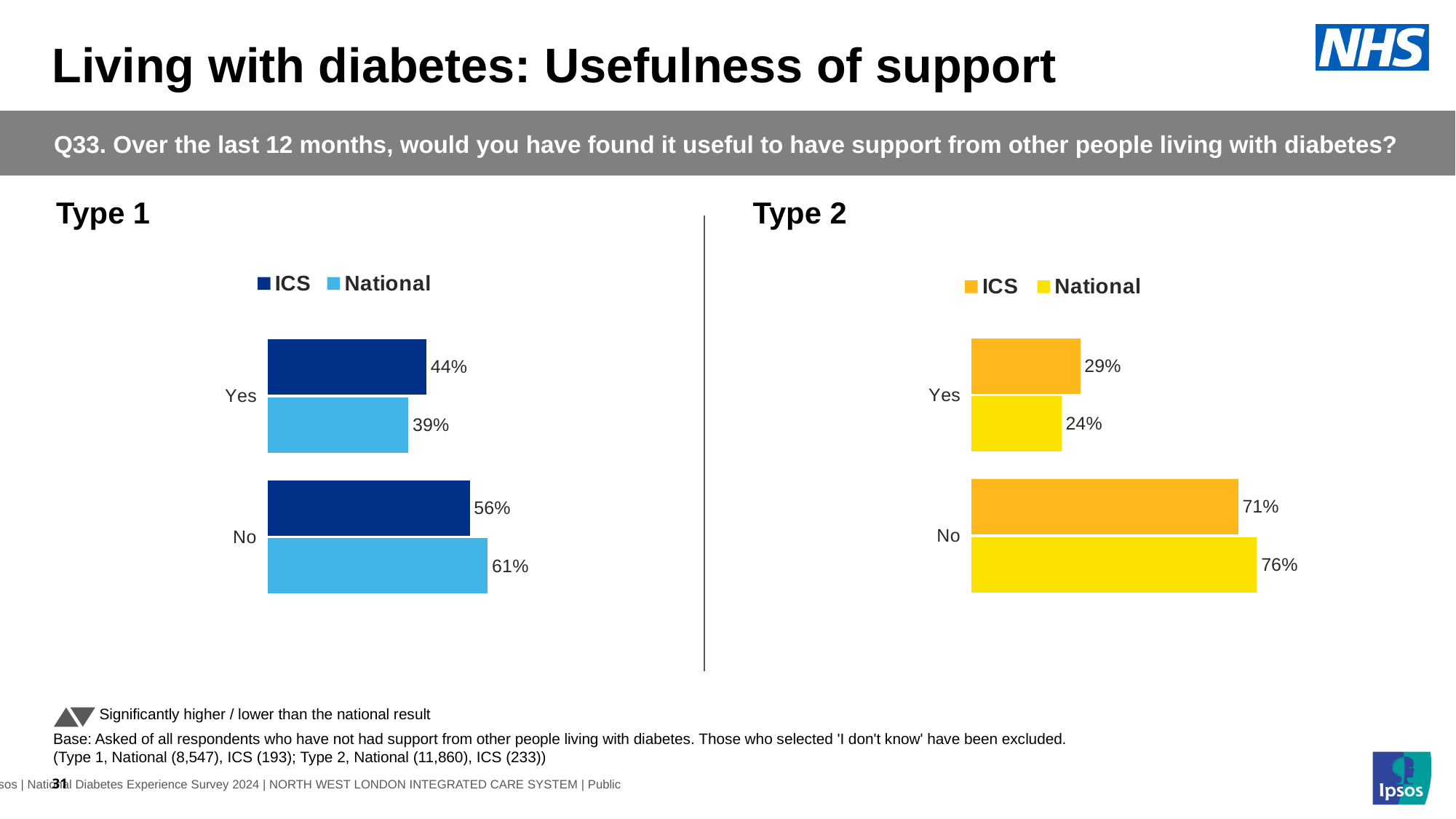
In the Type 2 chart, which series has the highest value shown? National (No, 76%) In the Type 1 chart, which is larger for Yes: ICS or National? ICS In the Type 2 chart, which is larger for No: ICS or National? National What kind of chart is the Type 1 chart? Bar chart How many series does the legend of the Type 1 chart list? 2 In the Type 2 chart, what is the National value for Yes? 24% In the Type 2 chart, what is the difference between the ICS and National values for Yes? 5 percentage points In the Type 1 chart, what is the difference between the ICS and National values for No? 5 percentage points In the Type 1 chart, what is the ICS value for Yes? 44% How many categories are shown in the Type 2 chart? 2 In the Type 1 chart, what is the National value for No? 61% In the Type 2 chart, what is the ICS value for No? 71%